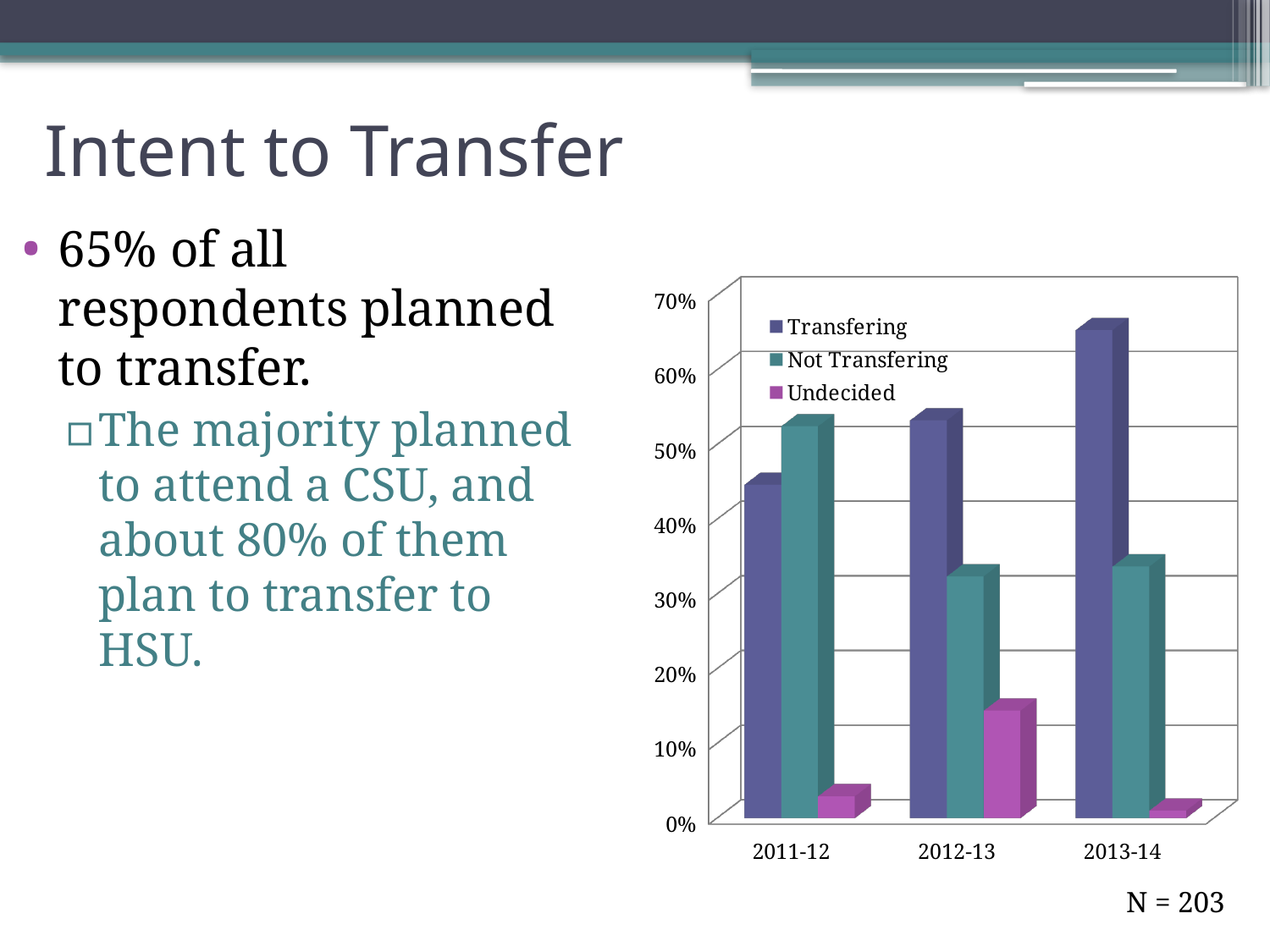
How many series does the chart's legend list? 3 Which series in the legend is shown in purple/magenta? Undecided Is the Transfering value for 2013-14 greater or less than 60%? greater How many academic years are shown on the x axis of the chart? 3 In 2011-12, which is larger: Transfering or Not Transfering? Not Transfering Which academic year has the highest Transfering value? 2013-14 Which academic year has the highest Undecided value? 2012-13 Is the Not Transfering value for 2012-13 greater or less than 40%? less In 2013-14, which is larger: Transfering or Not Transfering? Transfering Does the Transfering value rise or fall from 2011-12 to 2013-14? rise What kind of chart is shown on the slide? bar chart Which academic year has the lowest Transfering value? 2011-12